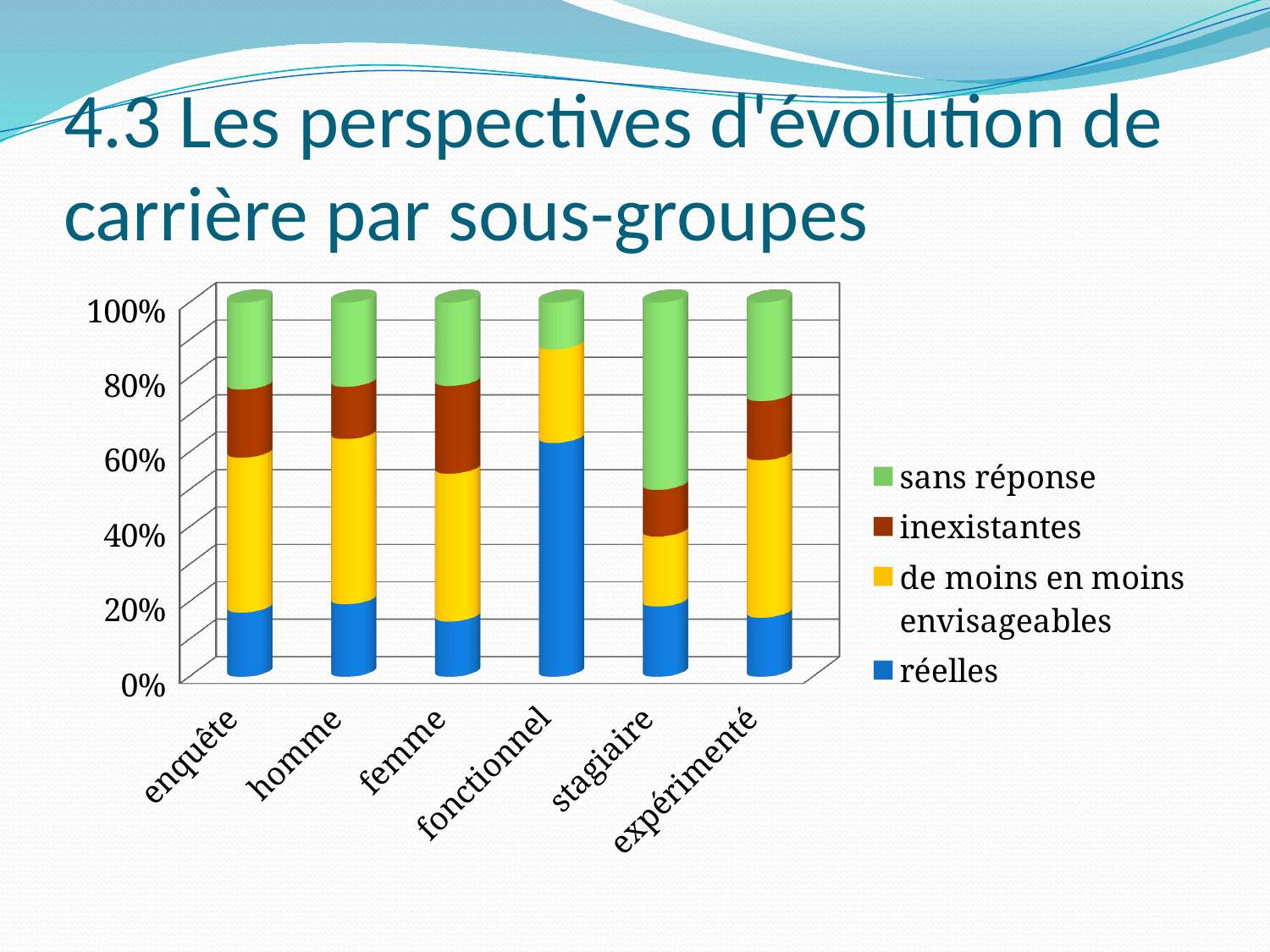
Is the 'réelles' share for femme greater or less than 20%? less Which is larger: the 'sans réponse' share for stagiaire or for homme? stagiaire Is the 'sans réponse' share for stagiaire greater or less than 40%? greater Which is larger: the 'réelles' share for fonctionnel or for stagiaire? fonctionnel Which category has the largest share of 'réelles'? fonctionnel How many series does the chart's legend list? 4 Is the 'réelles' share for fonctionnel greater or less than 40%? greater Which colour represents the 'réelles' series in the legend? Blue What kind of chart is shown on the slide? Stacked bar chart How many categories (sub-groups) are shown on the x axis of the chart? 6 Which category has the largest share of 'sans réponse'? stagiaire